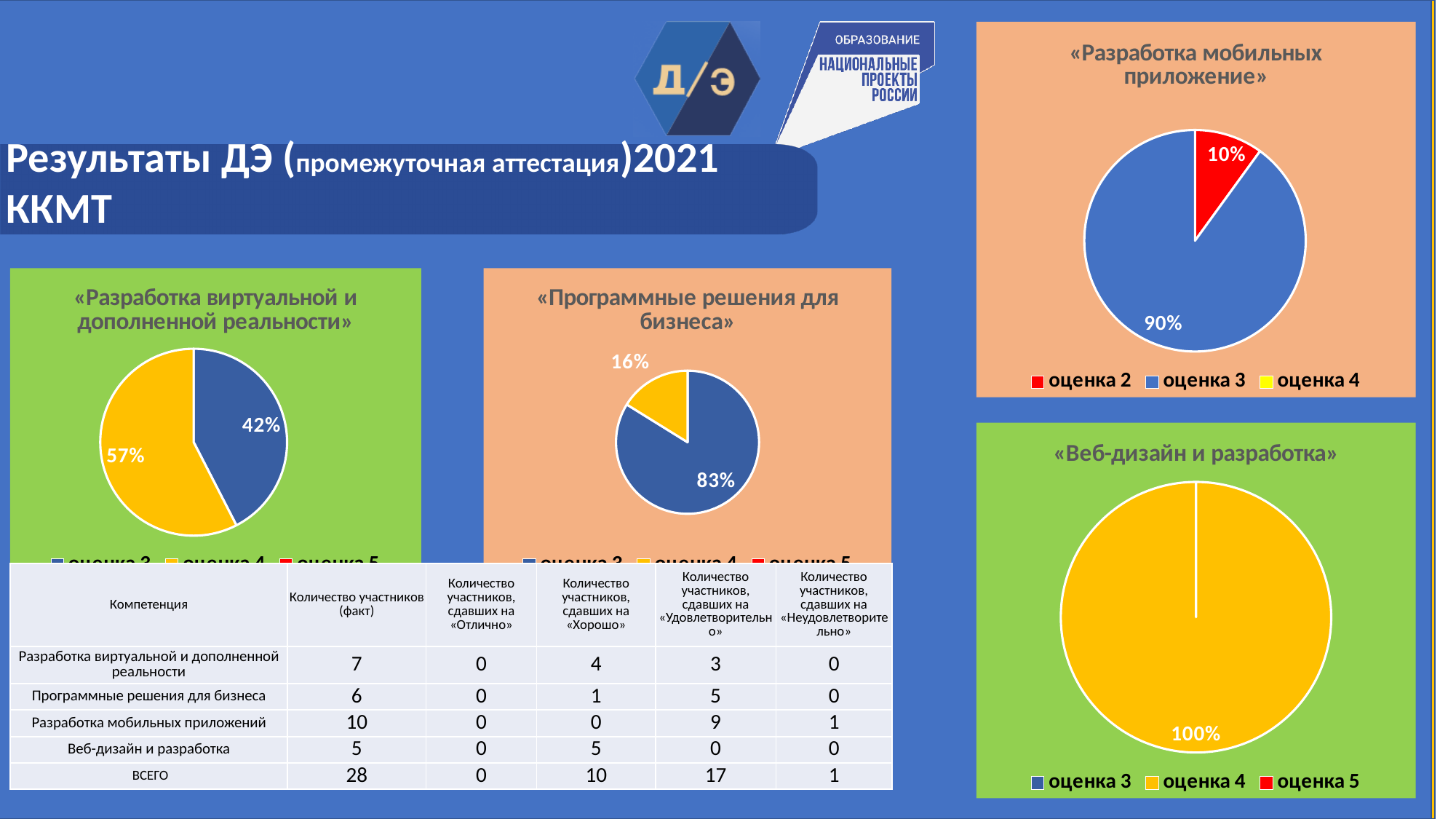
In the «Программные решения для бизнеса» chart, what percentage is shown on the blue slice? 83% In the «Разработка мобильных приложение» chart, what percentage is shown for оценка 3? 90% In the «Разработка мобильных приложение» chart, what percentage is shown for оценка 2? 10% In the «Веб-дизайн и разработка» chart, which category does the single slice represent? оценка 4 What kind of chart is used in the «Разработка мобильных приложение» chart? pie chart In the «Разработка мобильных приложение» chart, what is the difference in percentage points between the оценка 3 slice and the оценка 2 slice? 80 In the «Разработка виртуальной и дополненной реальности» chart, which slice is larger, the blue one or the yellow one? the yellow one In the «Разработка виртуальной и дополненной реальности» chart, what percentage is shown on the blue slice? 42% In the «Веб-дизайн и разработка» chart, what percentage is shown on the yellow slice? 100% How many entries does the legend of the «Разработка мобильных приложение» chart list? 3 In the «Разработка мобильных приложение» chart, which category has the largest slice? оценка 3 In the «Программные решения для бизнеса» chart, what is the difference in percentage points between the blue slice and the yellow slice? 67